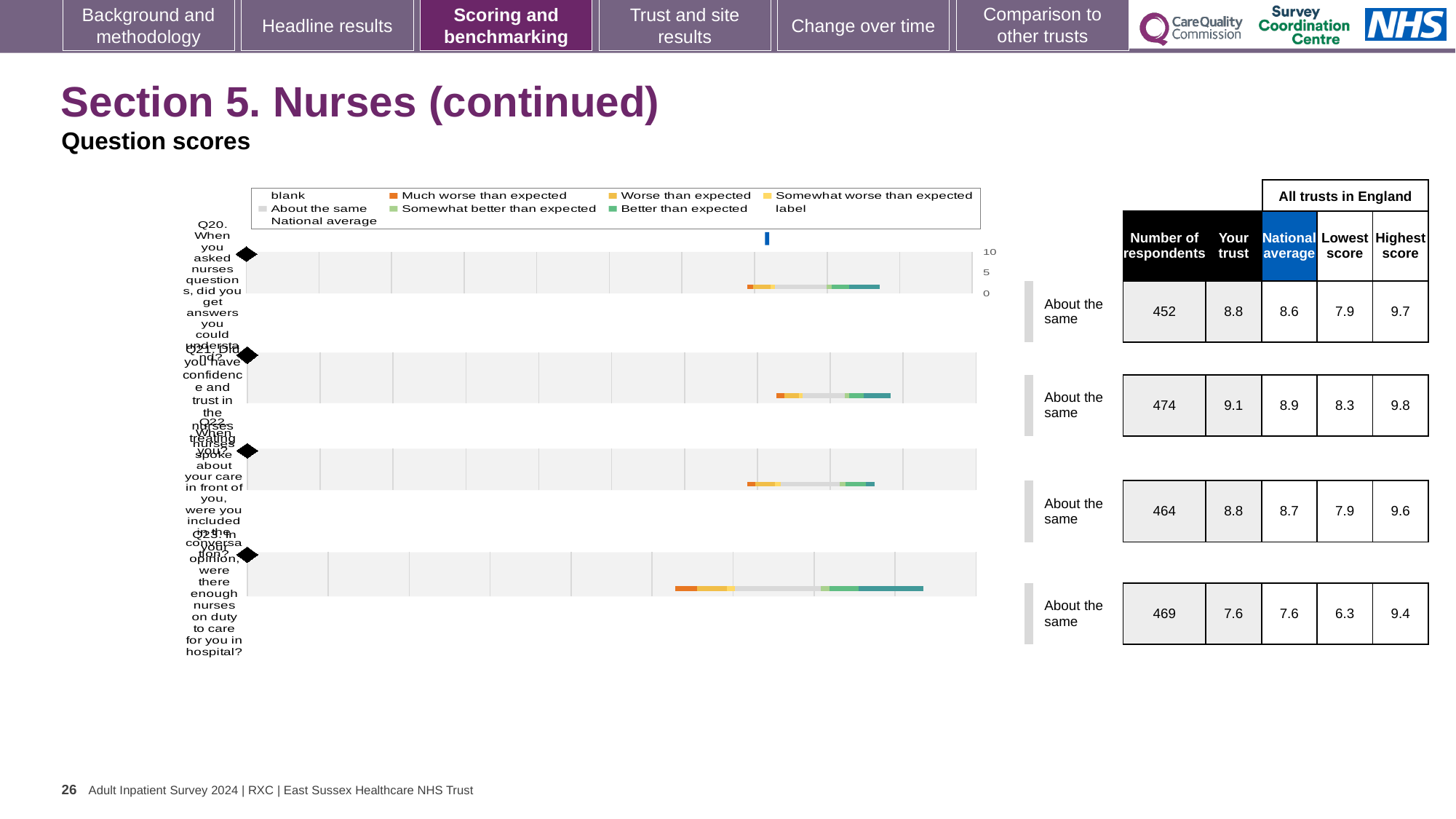
Which question has the highest 'Your trust' score? Q21 What is the difference between the 'Your trust' score and the national average for Q21? 0.2 How many respondents answered Q22 (were you included in the conversation)? 464 Is the 'Your trust' score for Q20 higher or lower than the national average for Q20? higher How many questions (categories) are plotted in the chart? 4 What kind of chart is used to show the question scores for Q20 to Q23? bar chart Which question has the lowest 'Your trust' score? Q23 What benchmark category is shown for Q23? About the same How many entries does the chart legend list? 9 Which colour does the legend use for 'Much worse than expected'? orange What is the national average score for Q21 (confidence and trust in the nurses treating you)? 8.9 What is the 'Your trust' score for Q23 (were there enough nurses on duty to care for you in hospital)? 7.6